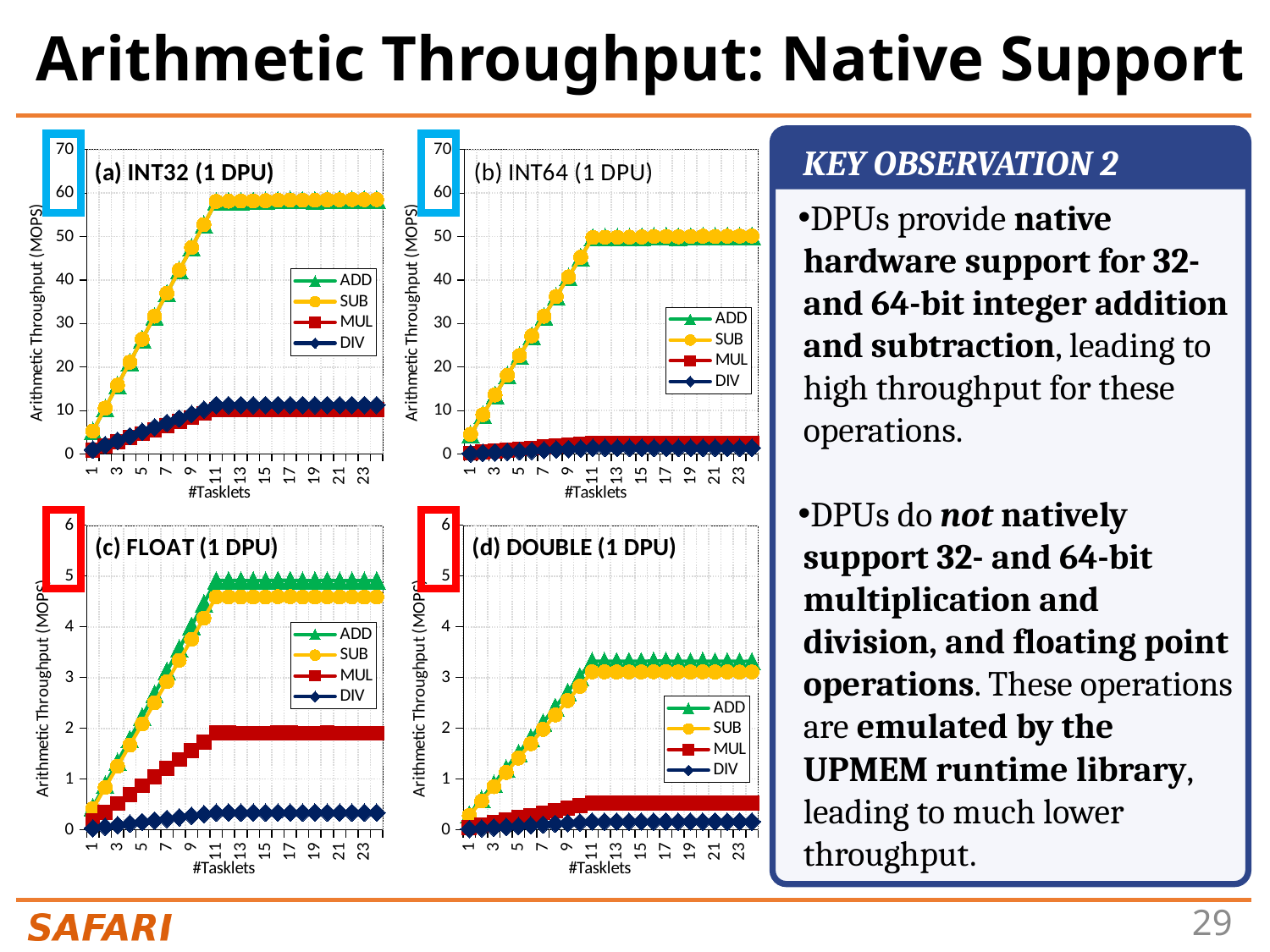
In the (b) INT64 (1 DPU) chart, is the MUL throughput at 23 tasklets greater or less than 10? less What kind of chart is the (a) INT32 (1 DPU) chart? line chart In the (b) INT64 (1 DPU) chart, is the SUB throughput at 23 tasklets greater or less than 40? greater How many series does the legend of the (c) FLOAT (1 DPU) chart list? 4 In the (c) FLOAT (1 DPU) chart, which series has the lowest throughput at 23 tasklets? DIV In the (c) FLOAT (1 DPU) chart, at 23 tasklets, which is larger: MUL or DIV? MUL In the (d) DOUBLE (1 DPU) chart, is the DIV throughput at 23 tasklets greater or less than 1? less In the (a) INT32 (1 DPU) chart, does the ADD throughput rise or fall as the number of tasklets increases from 1 to 11? rise What is the y-axis label of the (b) INT64 (1 DPU) chart? Arithmetic Throughput (MOPS)